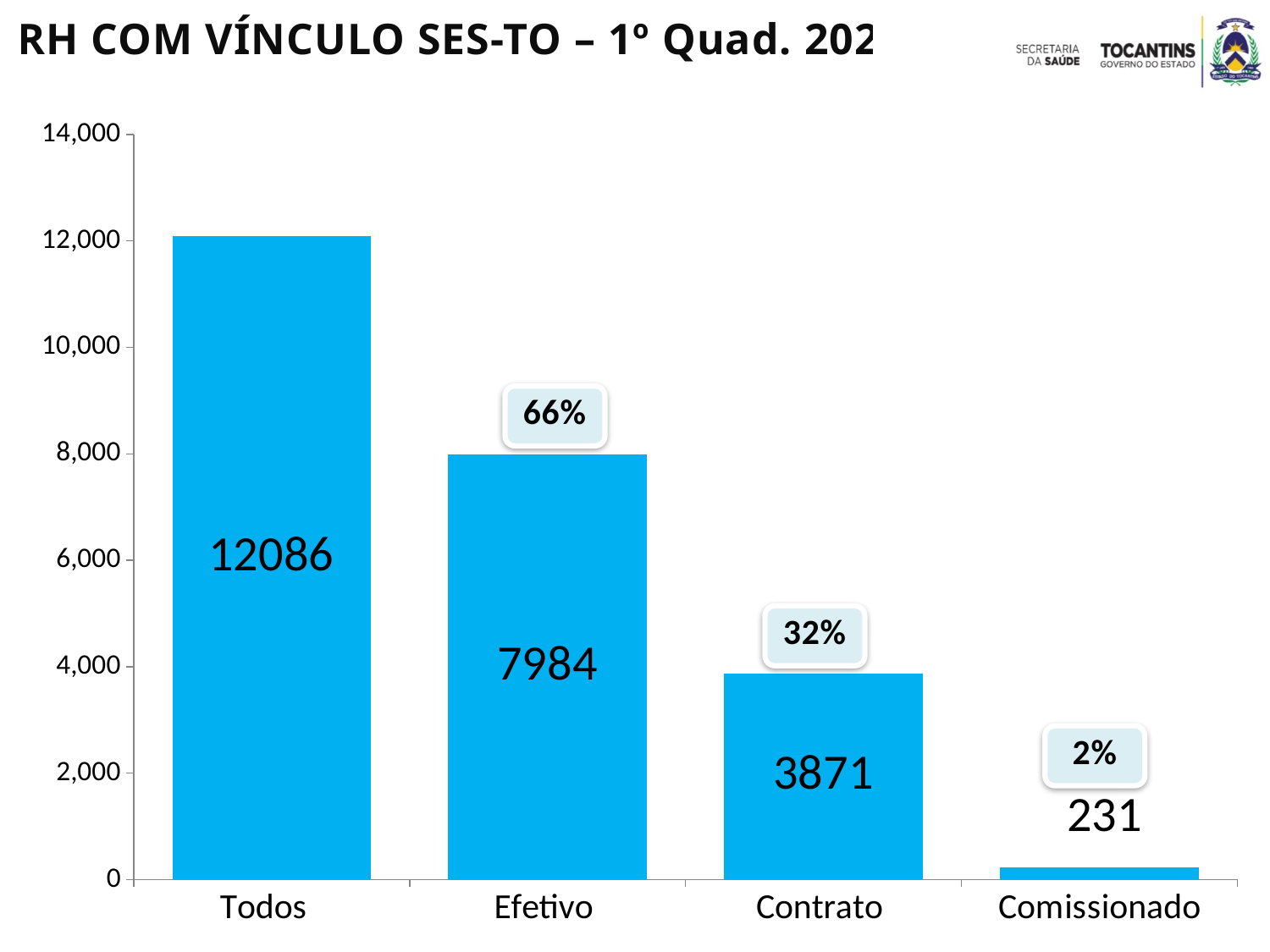
What is the value for Comissionado? 231 What kind of chart is shown on the slide? Bar chart Which category has the lowest value? Comissionado What is the value for Contrato? 3871 What is the value for Todos? 12086 What is the value for Efetivo? 7984 Which category has the highest value? Todos How many categories are shown on the x axis? 4 What percentage is shown above the Efetivo bar? 66% What is the difference between the values for Efetivo and Contrato? 4113 What percentage is shown above the Comissionado bar? 2% Which is larger, the value for Contrato or the value for Comissionado? Contrato